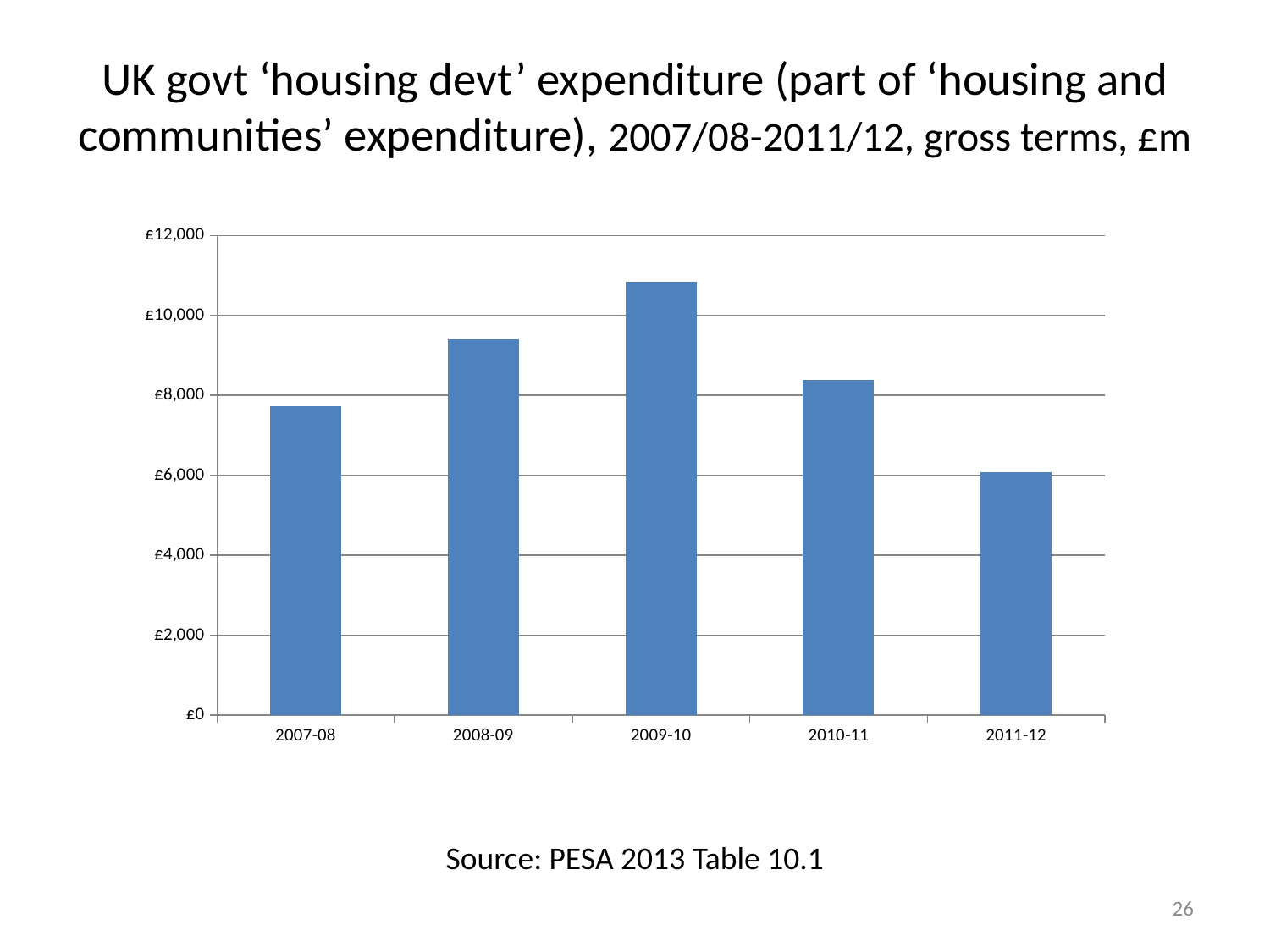
Which is larger, the value for 2008-09 or the value for 2010-11? 2008-09 Is the value for 2007-08 greater or less than £8,000? less Is the value for 2011-12 greater or less than £8,000? less How many financial years are plotted on the chart? 5 Is the value for 2009-10 greater or less than £10,000? greater From 2009-10 to 2011-12, do the values rise or fall? fall Which year has the lowest housing development expenditure? 2011-12 Which year has the highest housing development expenditure? 2009-10 What source is cited below the chart? PESA 2013 Table 10.1 What kind of chart is shown on the slide? bar chart